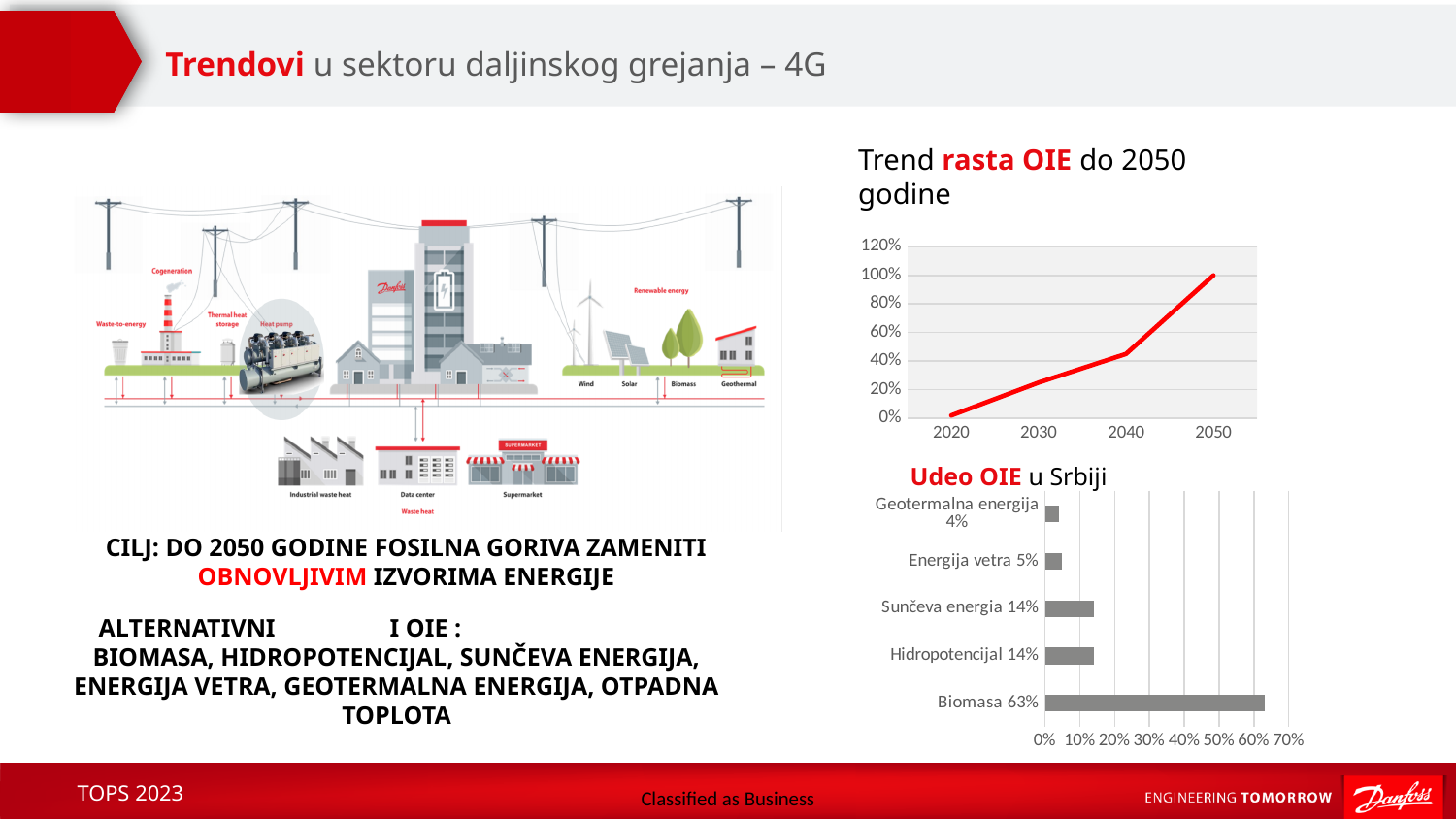
In the 'Trend rasta OIE do 2050 godine' chart, is the value for 2030 greater or less than 40%? less In the 'Udeo OIE u Srbiji' chart, which category has the highest value? Biomasa In the 'Udeo OIE u Srbiji' chart, what is the value for Biomasa? 63% In the 'Trend rasta OIE do 2050 godine' chart, do the values rise or fall from 2020 to 2050? Rise In the 'Trend rasta OIE do 2050 godine' chart, what is the value for 2050? 100% In the 'Udeo OIE u Srbiji' chart, what is the value for Geotermalna energija? 4% What type of chart is 'Trend rasta OIE do 2050 godine'? Line chart In the 'Udeo OIE u Srbiji' chart, what is the difference between Biomasa and Sunčeva energija? 49% In the 'Udeo OIE u Srbiji' chart, how many categories are shown? 5 In the 'Udeo OIE u Srbiji' chart, which category has the lowest value? Geotermalna energija In the 'Udeo OIE u Srbiji' chart, what is the value for Energija vetra? 5% What type of chart is 'Udeo OIE u Srbiji'? Bar chart